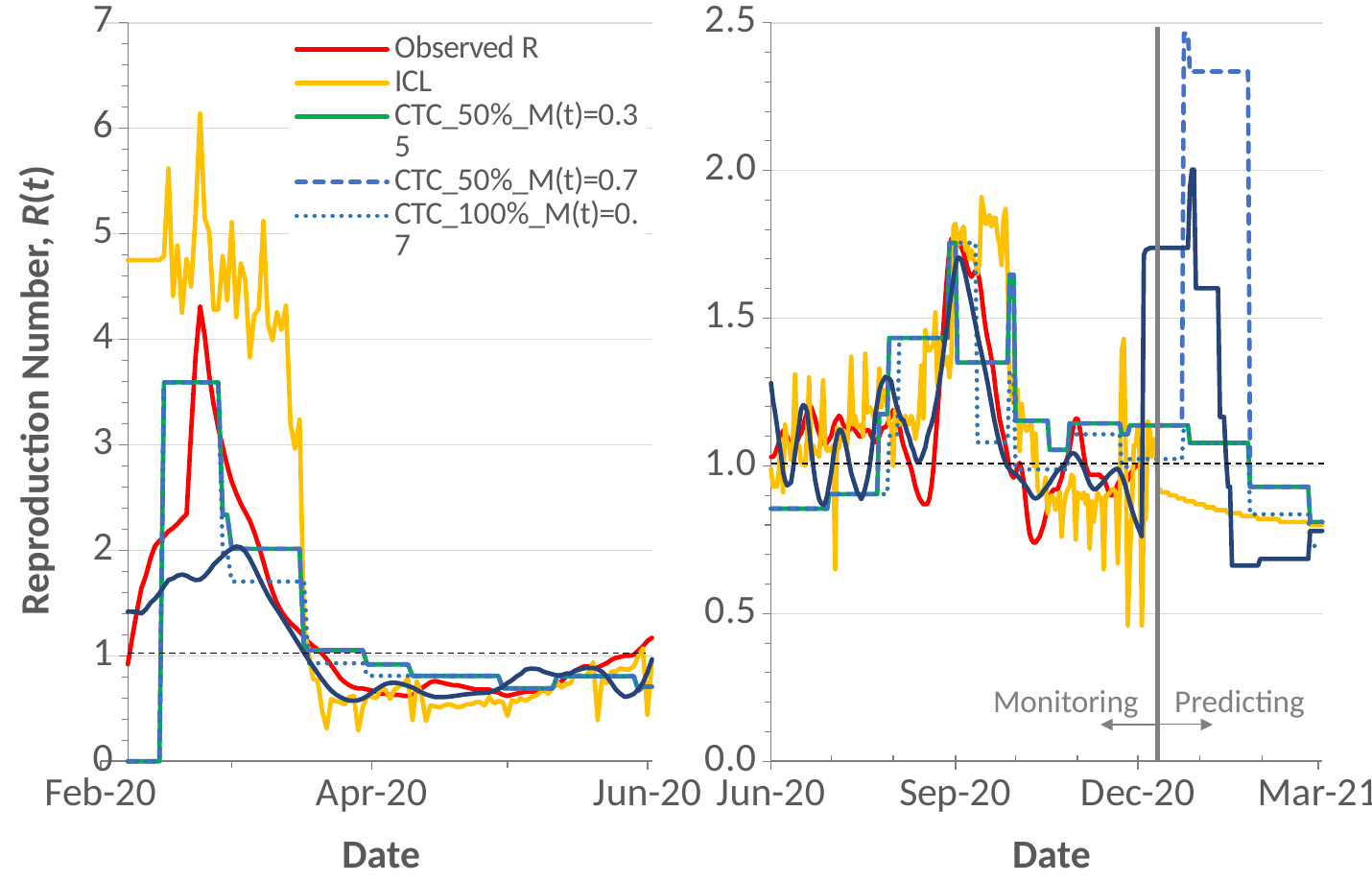
On the left chart (Feb-20 to Jun-20), is the value of the Observed R series at Apr-20 greater or less than 2? less On the right chart (Jun-20 to Mar-21), is the peak value of the ICL series greater or less than 1.5? greater On the right chart (Jun-20 to Mar-21), is the peak value of the CTC_50%_M(t)=0.7 series greater or less than 2.0? greater On the left chart, does the ICL series rise or fall from Feb-20 to Apr-20? fall What is the y-axis label of the left chart? Reproduction Number, R(t) What kind of chart is the left chart (Feb-20 to Jun-20)? line chart What two labels appear on either side of the vertical grey line on the right chart? Monitoring and Predicting How many series does the legend on the left chart list? 5